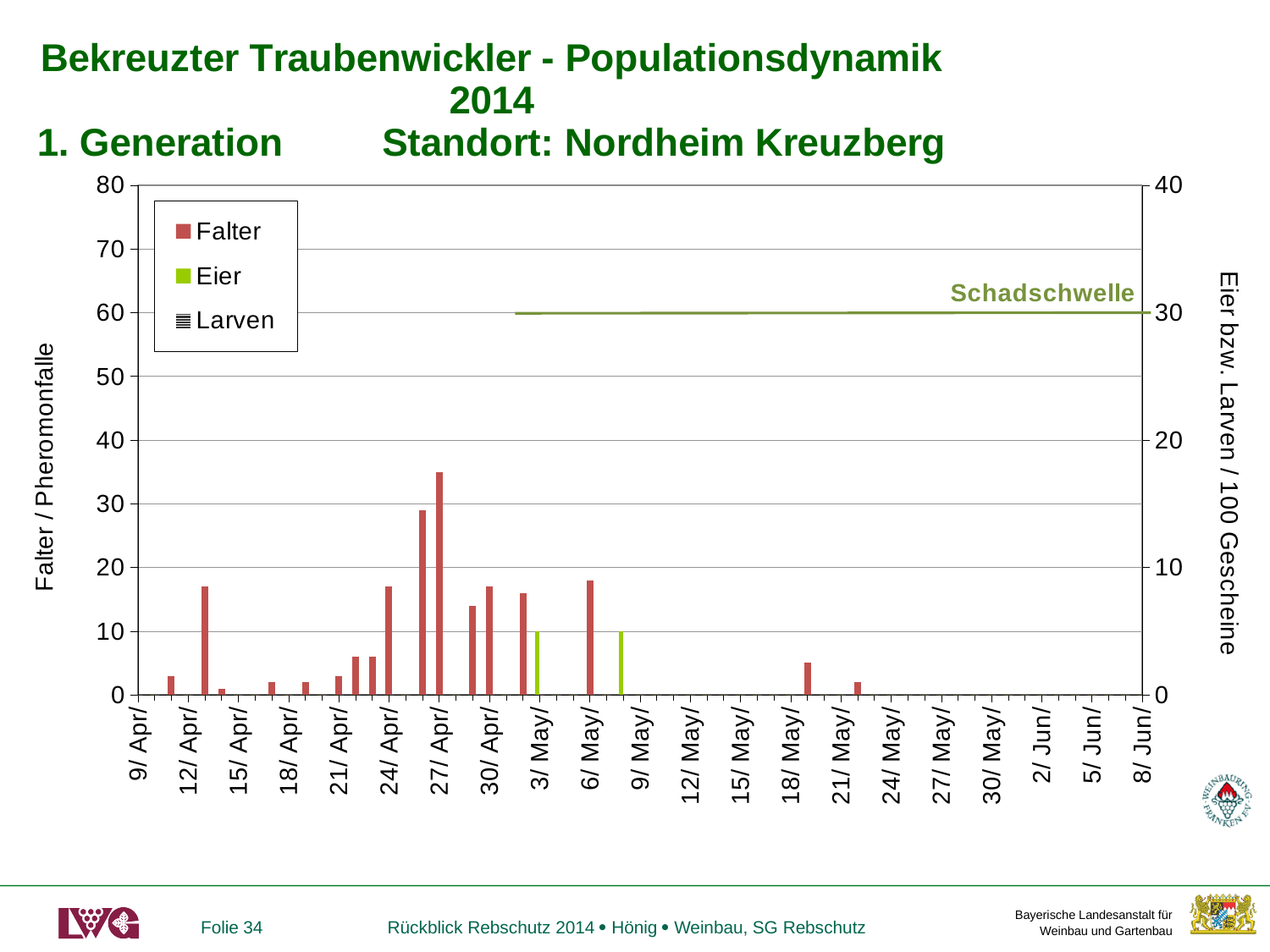
Is the Falter value on 27/ Apr greater or less than 30? greater Which series are listed in the chart legend? Falter, Eier, Larven Which is larger, the Falter value on 27/ Apr or on 24/ Apr? 27/ Apr Is the Falter value on 6/ May greater or less than 10? greater Is the Falter value on 12/ Apr greater or less than 20? less What is the title of the left vertical axis? Falter / Pheromonfalle At what value on the right axis is the Schadschwelle line drawn? 30 How many series does the legend list? 3 What kind of chart is shown on the slide? bar chart On which date does the Falter series reach its highest value? 27/ Apr